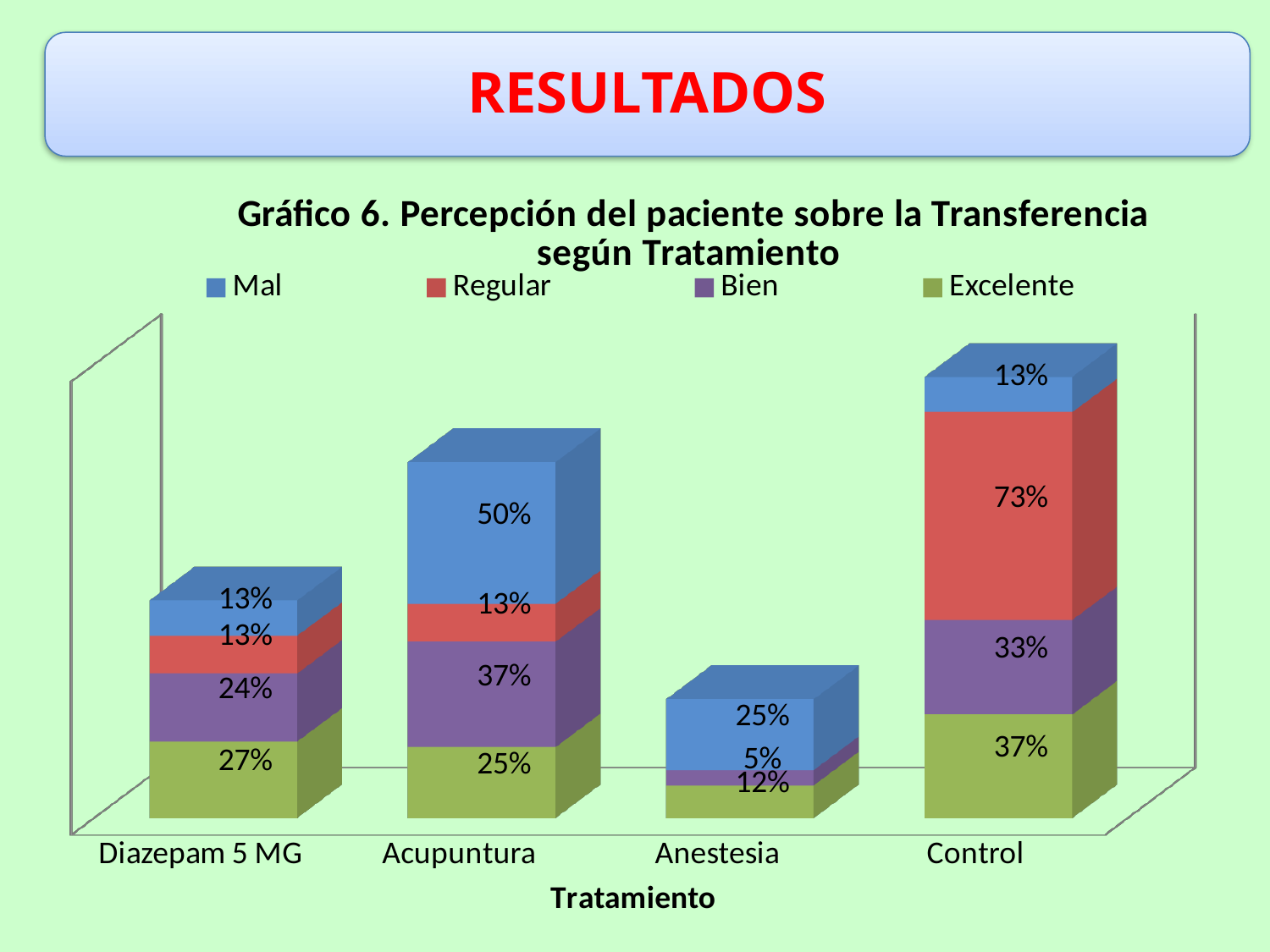
Which is larger: the Bien value for Diazepam 5 MG or the Bien value for Control? Control Which treatment has the highest value for the Mal series? Acupuntura Which treatment has the lowest value for the Excelente series? Anestesia What is the difference between the Regular value for Control and the Regular value for Acupuntura? 60% What is the value of the Mal series for Acupuntura? 50% How many series does the legend list? 4 Which treatment has the highest value for the Regular series? Control What is the value of the Excelente series for Diazepam 5 MG? 27% How many treatments are shown on the x axis? 4 What kind of chart is shown on the slide? Stacked bar chart What is the value of the Regular series for Control? 73% What is the value of the Bien series for Acupuntura? 37%